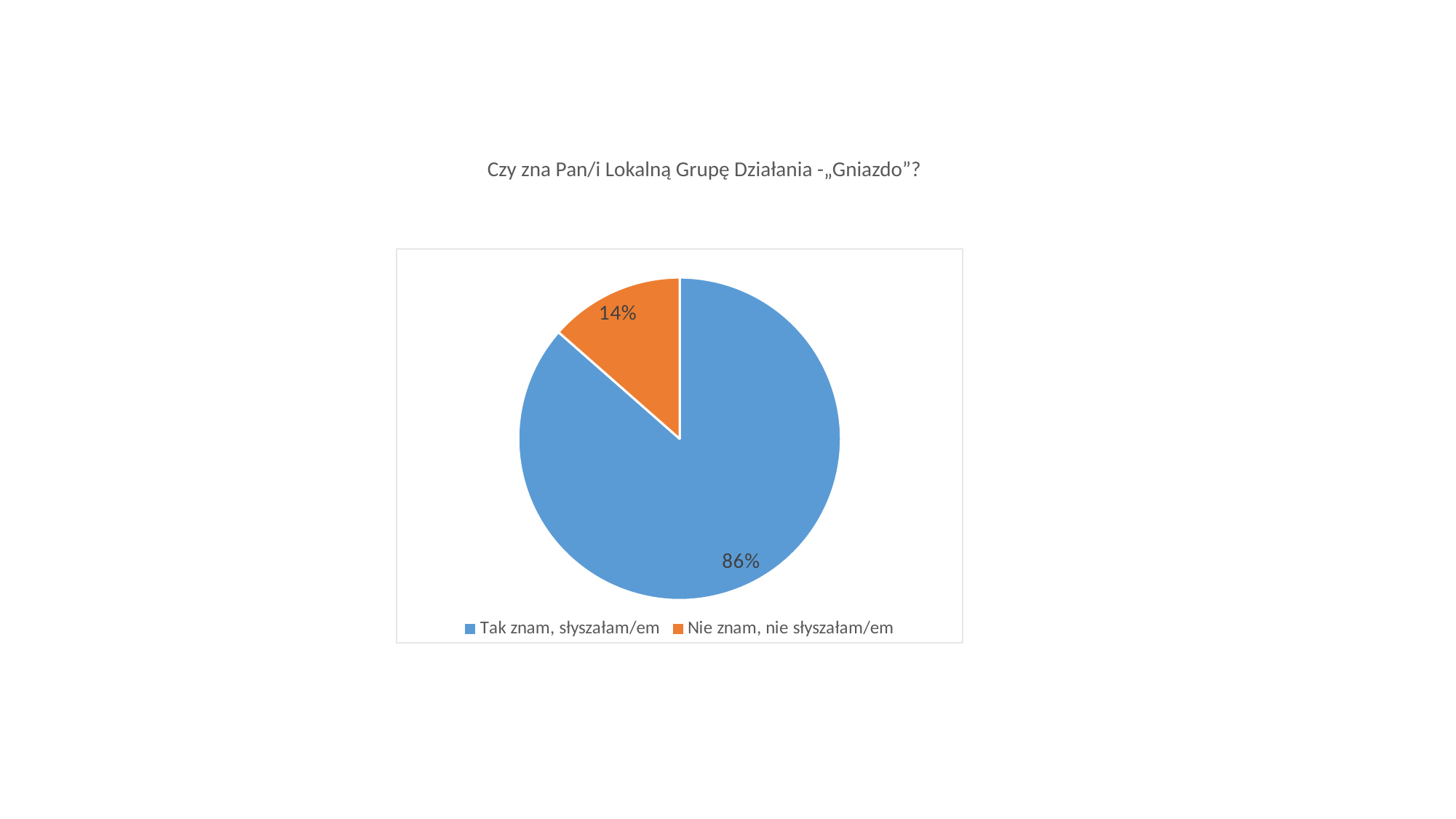
How many entries does the legend list? 2 What is the title of the chart? Czy zna Pan/i Lokalną Grupę Działania - „Gniazdo”? What kind of chart is shown on the slide? pie chart What colour is the slice for "Nie znam, nie słyszałam/em"? orange Which category has the largest slice of the pie? Tak znam, słyszałam/em What share of the pie is labelled "Tak znam, słyszałam/em"? 86% What is the difference in percentage points between the "Tak znam, słyszałam/em" slice and the "Nie znam, nie słyszałam/em" slice? 72 percentage points Which is larger: the "Tak znam, słyszałam/em" slice or the "Nie znam, nie słyszałam/em" slice? Tak znam, słyszałam/em How many categories does the pie chart show? 2 Which category has the smallest slice of the pie? Nie znam, nie słyszałam/em What share of the pie is labelled "Nie znam, nie słyszałam/em"? 14%